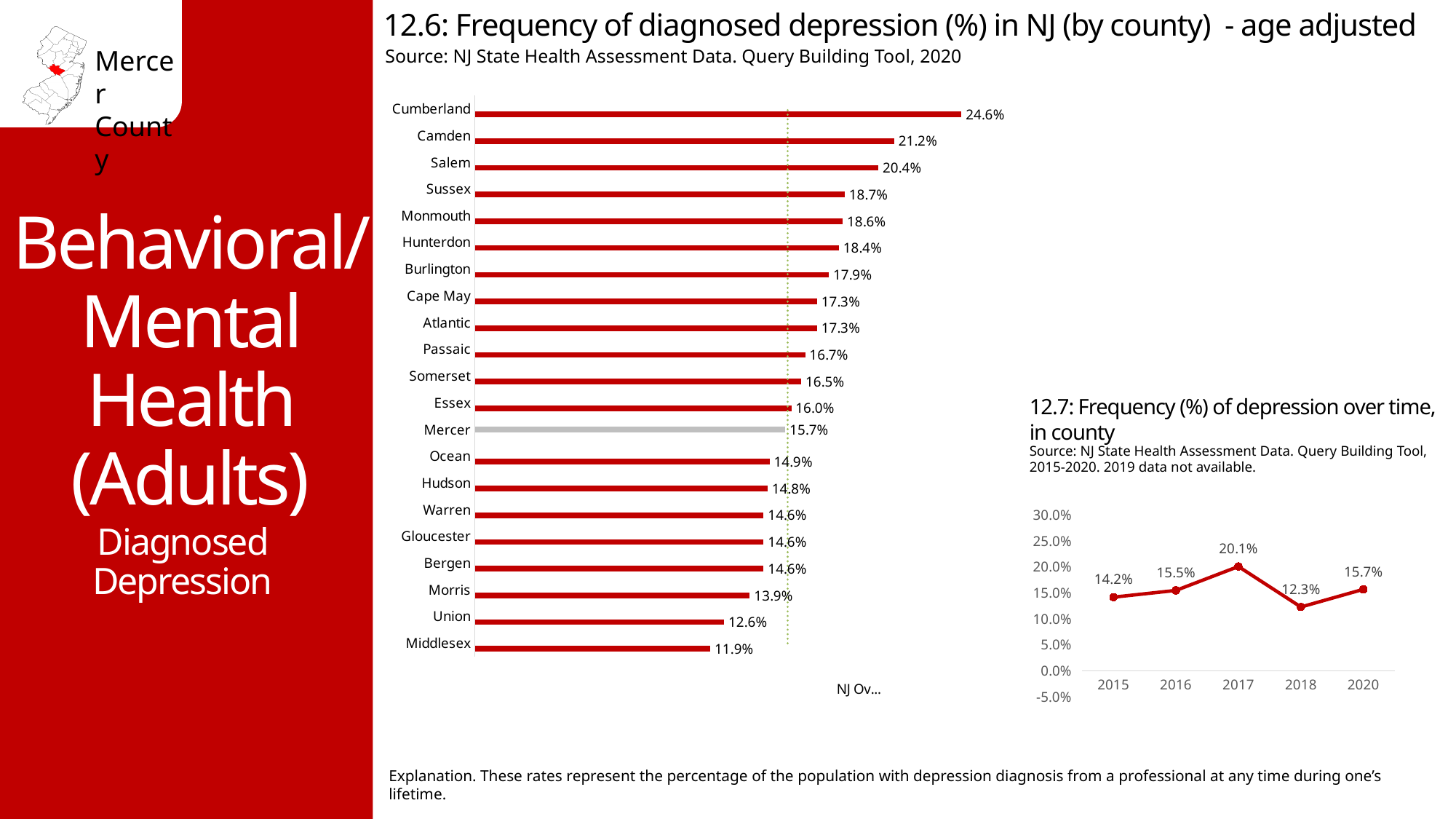
In the chart '12.7: Frequency (%) of depression over time, in county', what is the difference between 2017 and 2018? 7.8% In the chart '12.6: Frequency of diagnosed depression (%) in NJ (by county) - age adjusted', what is the value for Union? 12.6% In the chart '12.6: Frequency of diagnosed depression (%) in NJ (by county) - age adjusted', what is the value for Mercer? 15.7% In the chart '12.6: Frequency of diagnosed depression (%) in NJ (by county) - age adjusted', which is larger, Camden or Salem? Camden In the chart '12.6: Frequency of diagnosed depression (%) in NJ (by county) - age adjusted', how many counties are shown? 21 In the chart '12.7: Frequency (%) of depression over time, in county', what is the value for 2017? 20.1% In the chart '12.7: Frequency (%) of depression over time, in county', which year has the lowest value? 2018 In the chart '12.6: Frequency of diagnosed depression (%) in NJ (by county) - age adjusted', which county has the highest value? Cumberland What kind of chart is '12.6: Frequency of diagnosed depression (%) in NJ (by county) - age adjusted'? Bar chart What kind of chart is '12.7: Frequency (%) of depression over time, in county'? Line chart In the chart '12.6: Frequency of diagnosed depression (%) in NJ (by county) - age adjusted', what is the difference between Cumberland and Middlesex? 12.7% In the chart '12.6: Frequency of diagnosed depression (%) in NJ (by county) - age adjusted', which county has the lowest value? Middlesex